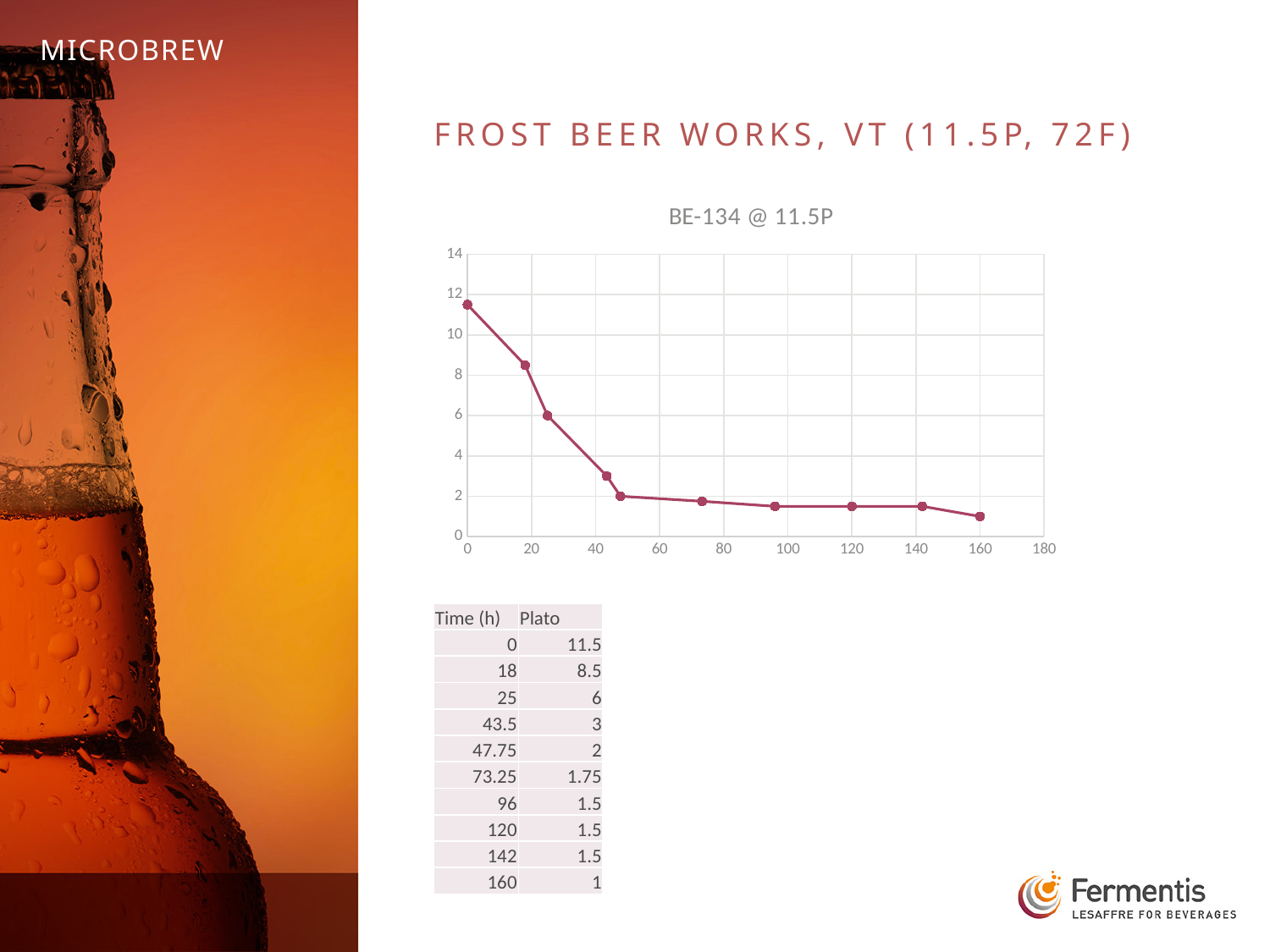
What is the Plato value at 18 h? 8.5 At which time is the Plato value highest? 0 h What is the title of the chart? BE-134 @ 11.5P At which time is the Plato value lowest? 160 h Which has the larger Plato value, 25 h or 43.5 h? 25 h How many data points are plotted on the chart? 10 What is the Plato value at 160 h? 1 Do the Plato values rise or fall as time increases along the x axis? fall What is the Plato value at time 0 h? 11.5 What is the Plato value at 73.25 h? 1.75 What kind of chart is shown on the slide? line chart What is the difference in Plato between 0 h and 18 h? 3